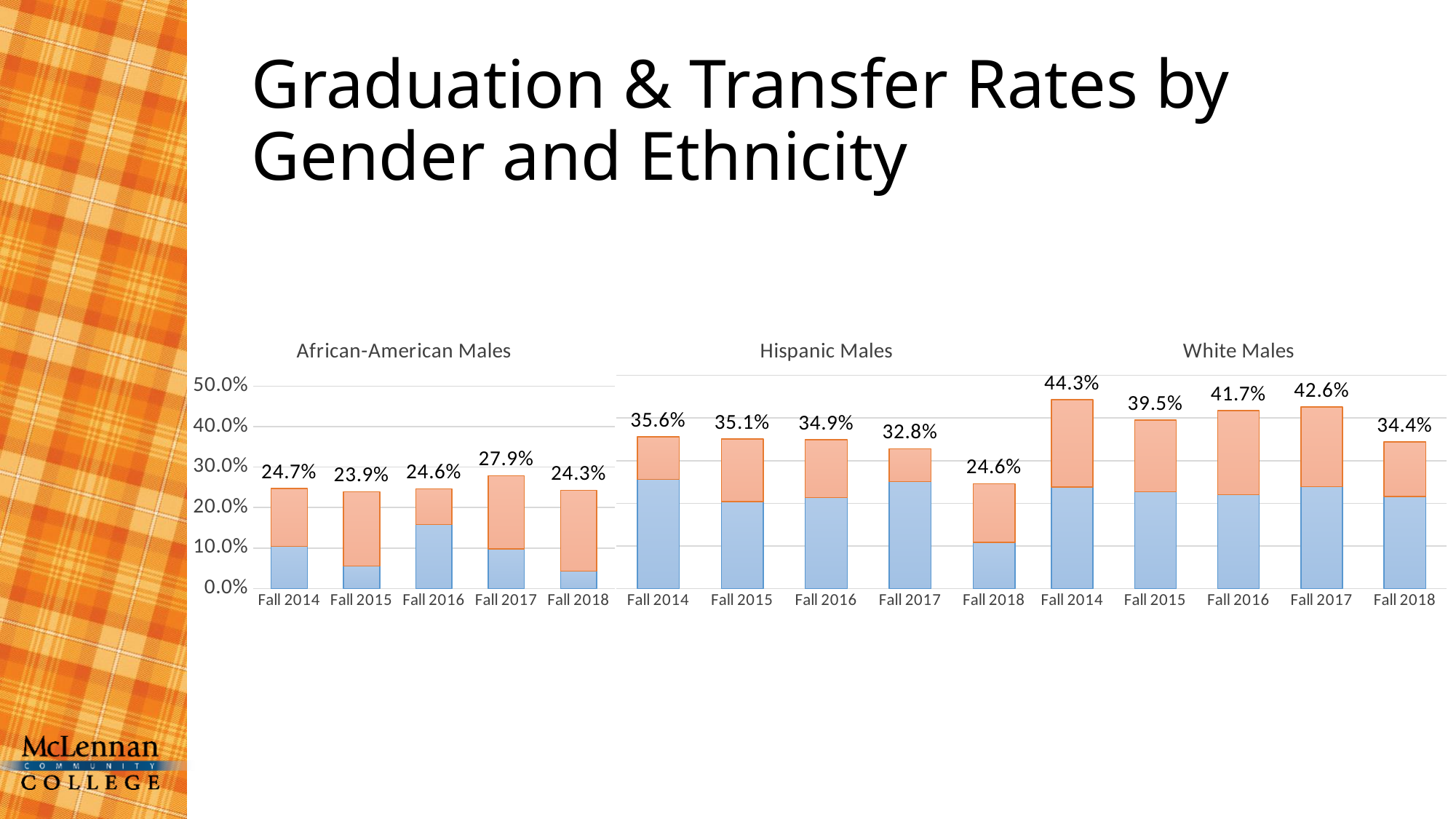
In the Hispanic Males chart, do the labelled totals rise or fall from Fall 2014 to Fall 2018? Fall In the African-American Males chart, which term has the highest labelled total rate? Fall 2017 Which is larger: the Fall 2018 total for Hispanic Males or the Fall 2018 total for African-American Males? Hispanic Males In the Hispanic Males chart, what is the difference between the Fall 2014 and Fall 2018 labelled totals? 11.0 percentage points In the Hispanic Males chart, which term has the lowest labelled total rate? Fall 2018 In the White Males chart, which term has the highest labelled total rate? Fall 2014 In the White Males chart, what is the total rate labelled for Fall 2016? 41.7% In the African-American Males chart, what is the total rate labelled for Fall 2017? 27.9% In the Hispanic Males chart, what is the total rate labelled for Fall 2018? 24.6% In the African-American Males chart, is the blue (bottom) segment for Fall 2018 greater or less than 10.0%? less How many terms are shown on the x axis of the White Males chart? 5 In the White Males chart, what is the difference between the Fall 2014 and Fall 2018 labelled totals? 9.9 percentage points